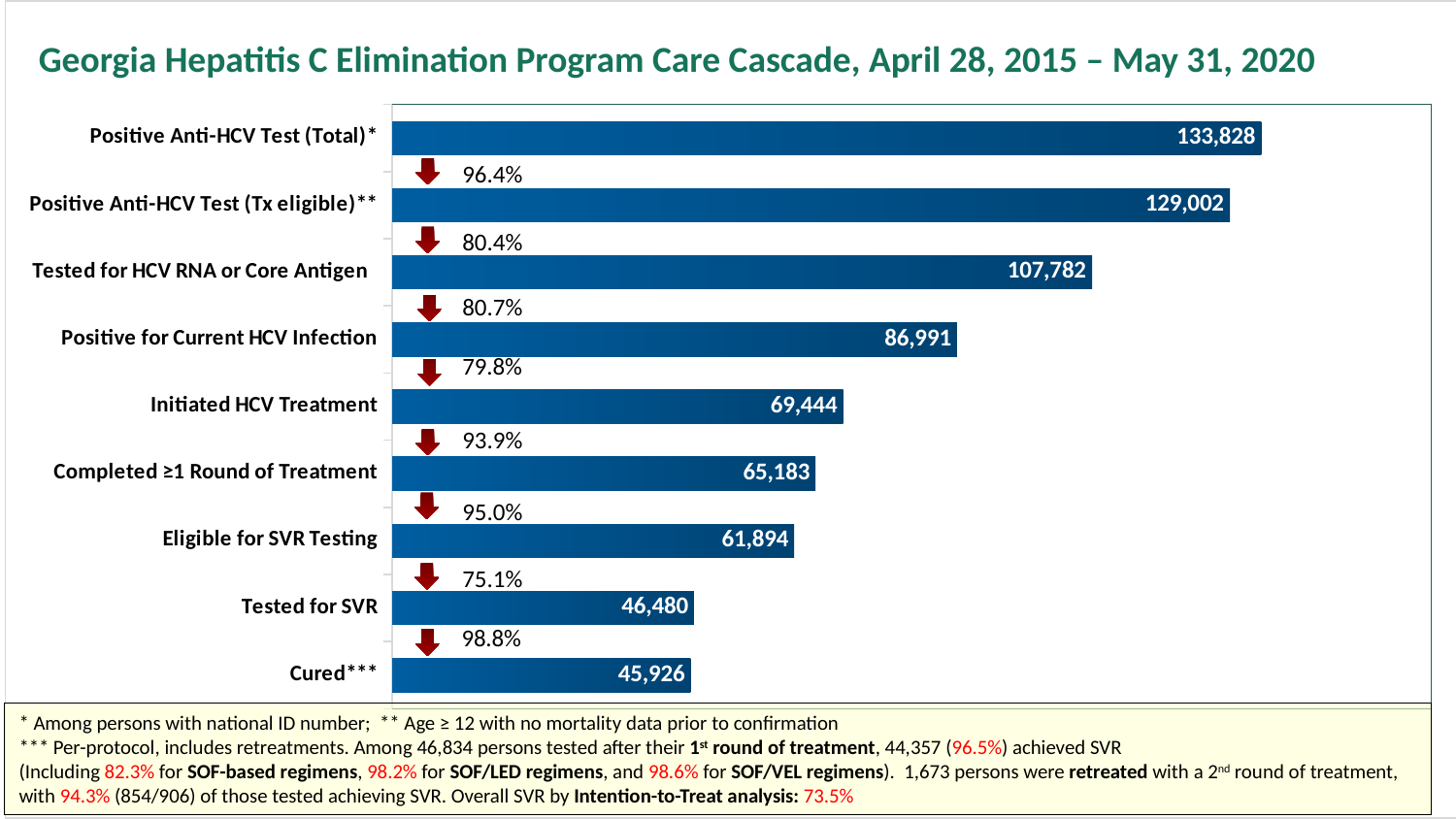
What is the value for Tested for HCV RNA or Core Antigen? 107,782 What is the difference between Tested for SVR and Cured***? 554 Which category has the highest value? Positive Anti-HCV Test (Total)* What is the difference between Positive Anti-HCV Test (Total)* and Positive Anti-HCV Test (Tx eligible)**? 4,826 How many categories are shown in the chart? 9 Which is larger, Completed ≥1 Round of Treatment or Eligible for SVR Testing? Completed ≥1 Round of Treatment What is the value for Positive Anti-HCV Test (Total)*? 133,828 What kind of chart is this? Bar chart What is the value for Initiated HCV Treatment? 69,444 What is the value for Cured***? 45,926 Which category has the lowest value? Cured*** Do the values rise or fall going down the chart from Positive Anti-HCV Test (Total)* to Cured***? Fall